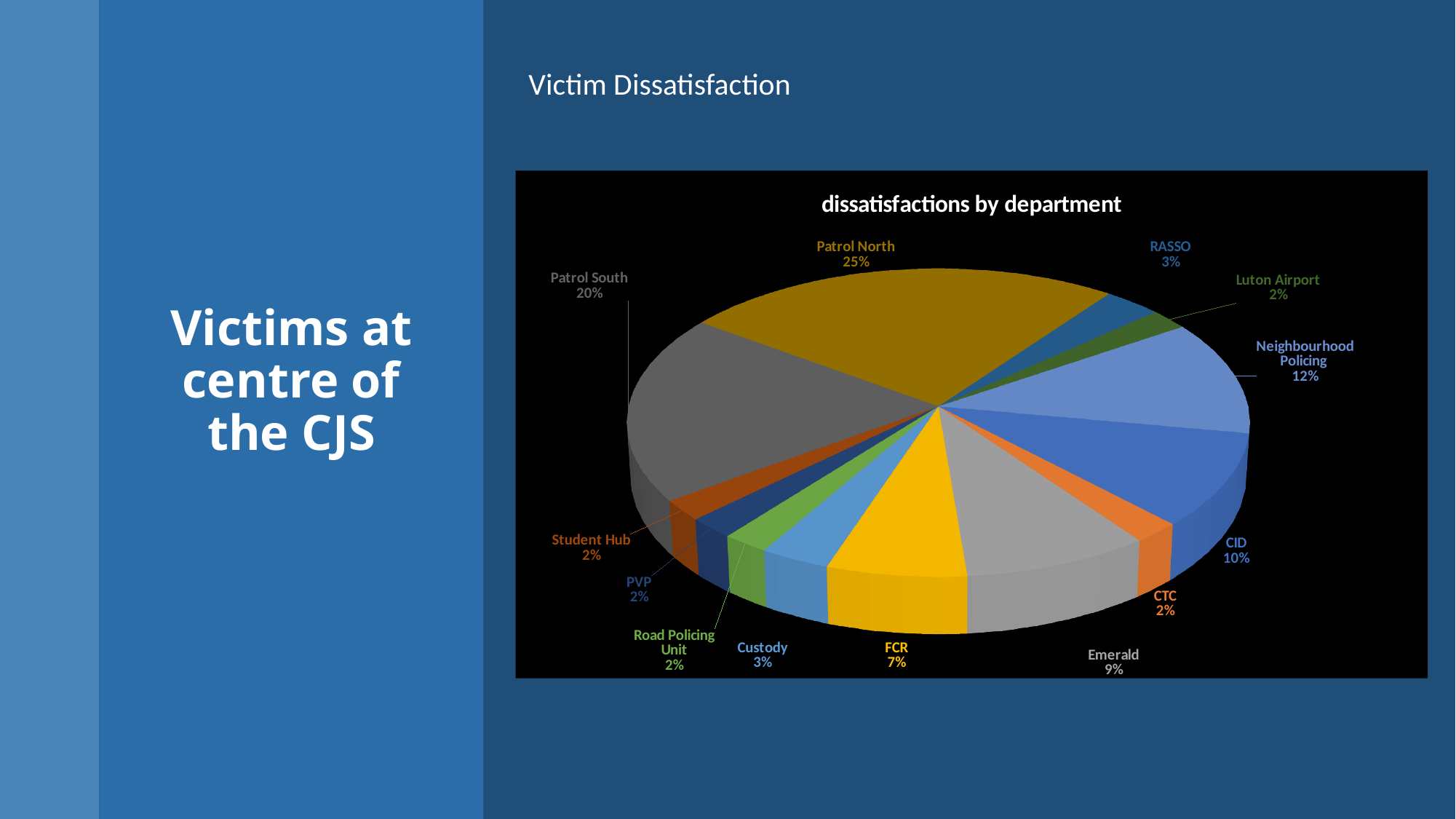
What percentage is shown for Custody? 3% How many departments are shown in the pie chart? 13 Which department has the largest share of dissatisfactions? Patrol North Which has a larger share, CID or FCR? CID What share of dissatisfactions does Patrol North account for? 25% What is the difference in percentage points between Patrol North and Patrol South? 5 What percentage is shown for Neighbourhood Policing? 12% What is the difference in percentage points between Neighbourhood Policing and CID? 2 What is the title of the chart? dissatisfactions by department What percentage is shown for Emerald? 9% Which has a larger share, Emerald or RASSO? Emerald What type of chart is shown on the slide? Pie chart